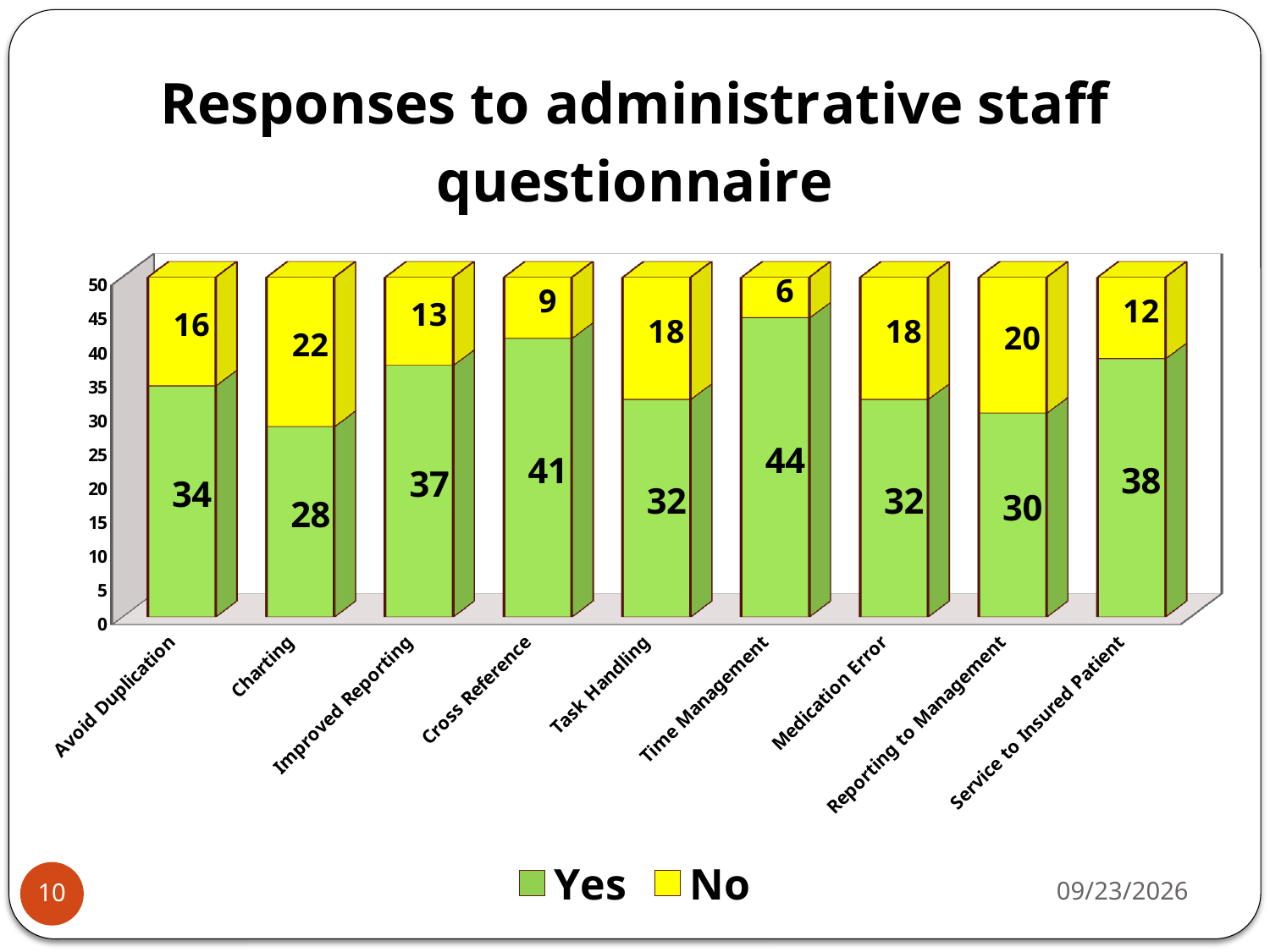
What is the difference between the Yes values for Cross Reference and Task Handling? 9 Which is larger, the No value for Avoid Duplication or the No value for Reporting to Management? Reporting to Management How many categories are shown on the x axis? 9 What is the Yes value for Time Management? 44 What is the Yes value for Service to Insured Patient? 38 Which category has the lowest No value? Time Management Which category has the lowest Yes value? Charting What is the total of the stacked bar for Improved Reporting? 50 How many series does the legend list? 2 Which category has the highest Yes value? Time Management What kind of chart is shown on the slide? Stacked bar chart What is the No value for Charting? 22